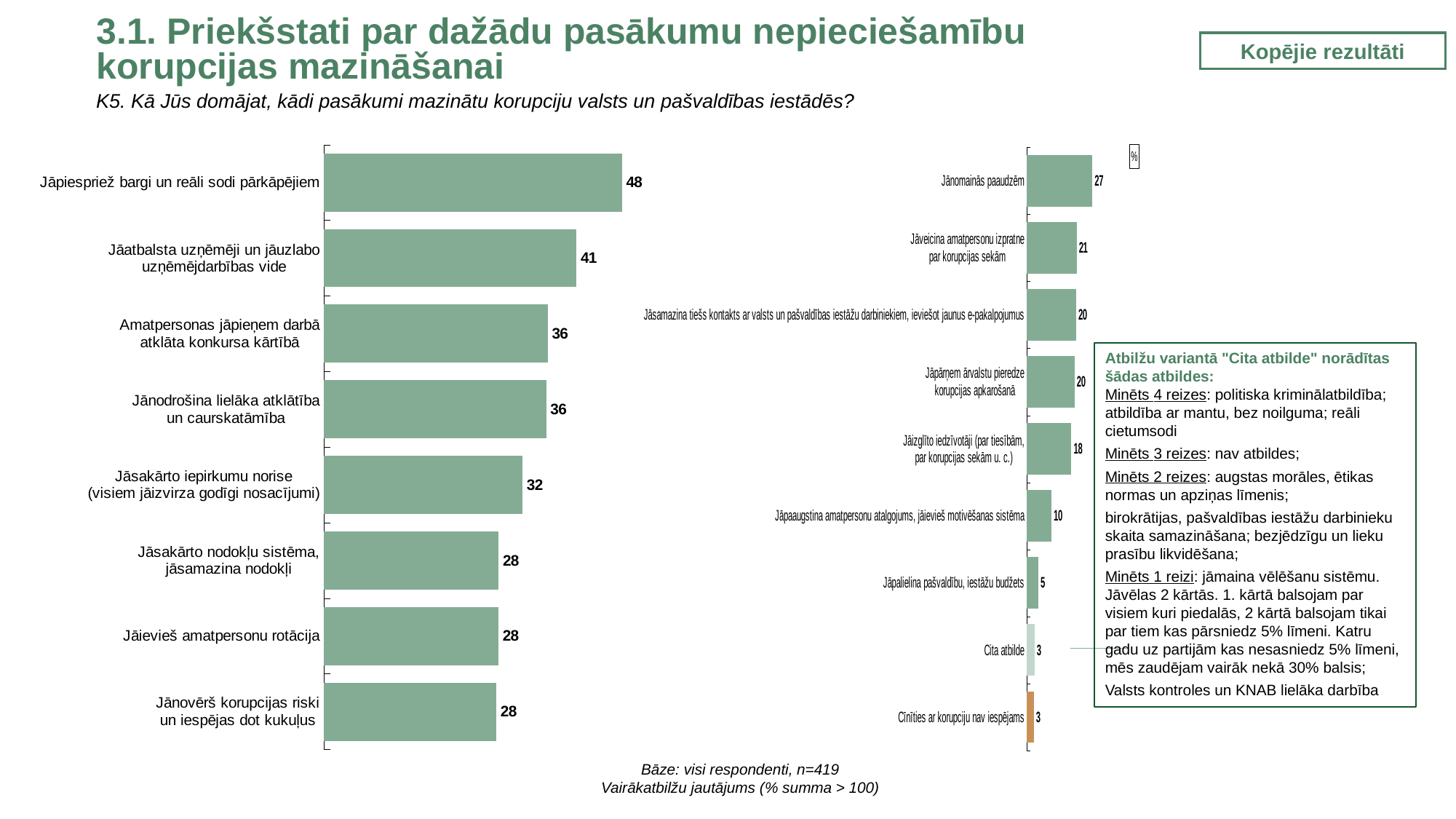
In the right chart, what is the value for "Jāpaaugstina amatpersonu atalgojums, jāievieš motivēšanas sistēma"? 10 In the right chart, what is the value for "Jānomainās paaudzēm"? 27 In the left chart, what is the difference between the values for "Jāpiespriež bargi un reāli sodi pārkāpējiem" and "Jāatbalsta uzņēmēji un jāuzlabo uzņēmējdarbības vide"? 7 In the left chart, what is the value for "Jāsakārto iepirkumu norise (visiem jāizvirza godīgi nosacījumi)"? 32 How many categories are shown in the right chart? 9 What type of chart is the left chart? Bar chart In the left chart, what is the value for "Jāpiespriež bargi un reāli sodi pārkāpējiem"? 48 In the right chart, what is the difference between the values for "Jānomainās paaudzēm" and "Jāpalielina pašvaldību, iestāžu budžets"? 22 How many categories are shown in the left chart? 8 In the left chart, which category has the highest value? Jāpiespriež bargi un reāli sodi pārkāpējiem In the right chart, which category has the highest value? Jānomainās paaudzēm In the right chart, which is larger: the value for "Jāveicina amatpersonu izpratne par koruptijas sekām" or the value for "Jāizglīto iedzīvotāji (par tiesībām, par korupcijas sekām u. c.)"? Jāveicina amatpersonu izpratne par korupcijas sekām